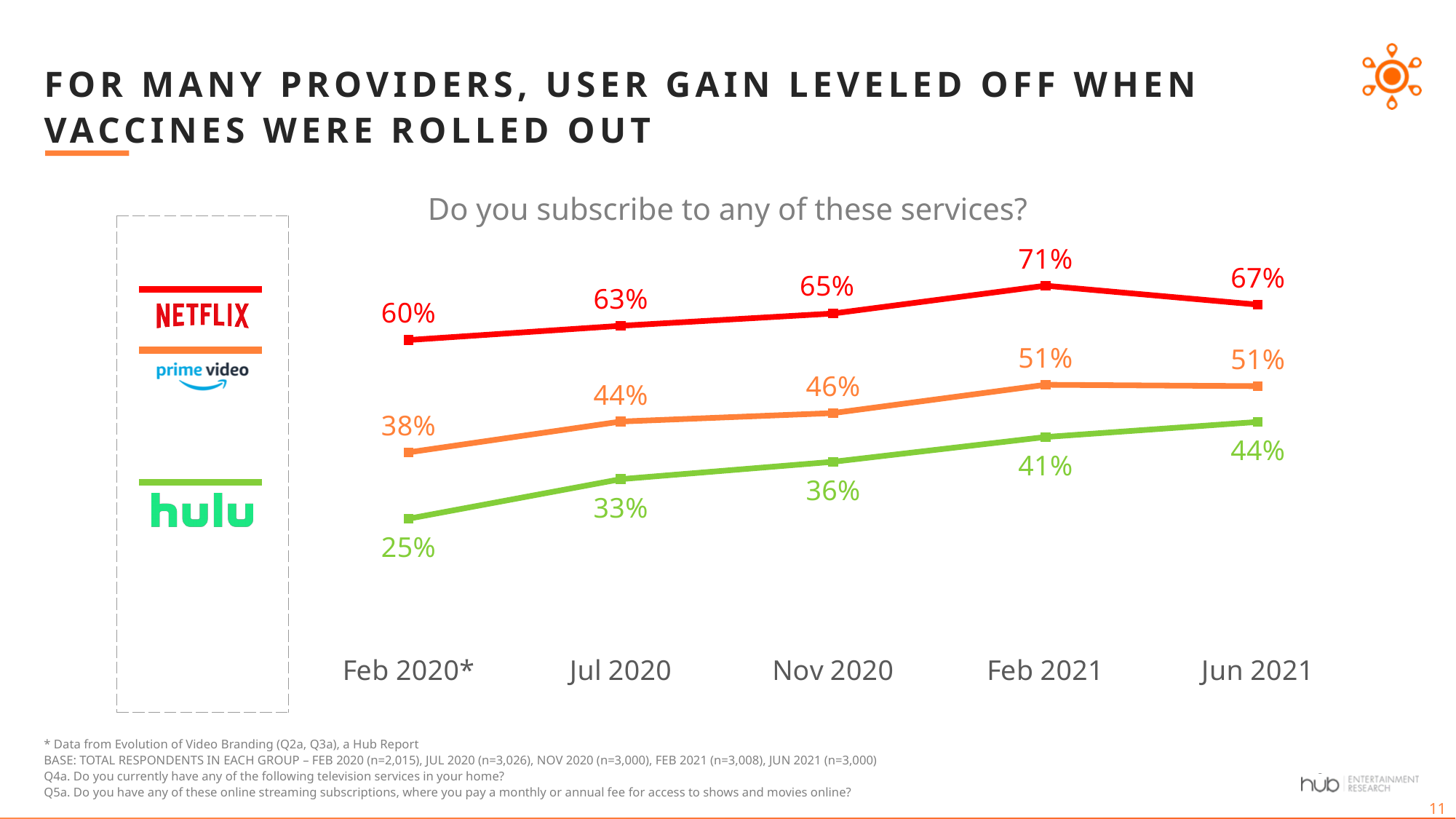
How many time periods are shown on the x axis? 5 What is the difference between the Netflix and Hulu values in Jun 2021? 23 percentage points Which service had the lowest subscription rate in Jun 2021? Hulu Did the Netflix value rise or fall between Feb 2021 and Jun 2021? Fall How many services (series) are plotted on the chart? 3 What type of chart is shown on the slide? Line chart Which is larger: Prime Video in Jul 2020 or Hulu in Jun 2021? Neither; they are equal (both 44%) What was the Prime Video value in Nov 2020? 46% By how many percentage points did Hulu grow from Feb 2020 to Jun 2021? 19 percentage points What percentage of respondents subscribed to Netflix in Feb 2021? 71% In which period did Netflix reach its highest value? Feb 2021 What was the Hulu subscription rate in Feb 2020? 25%